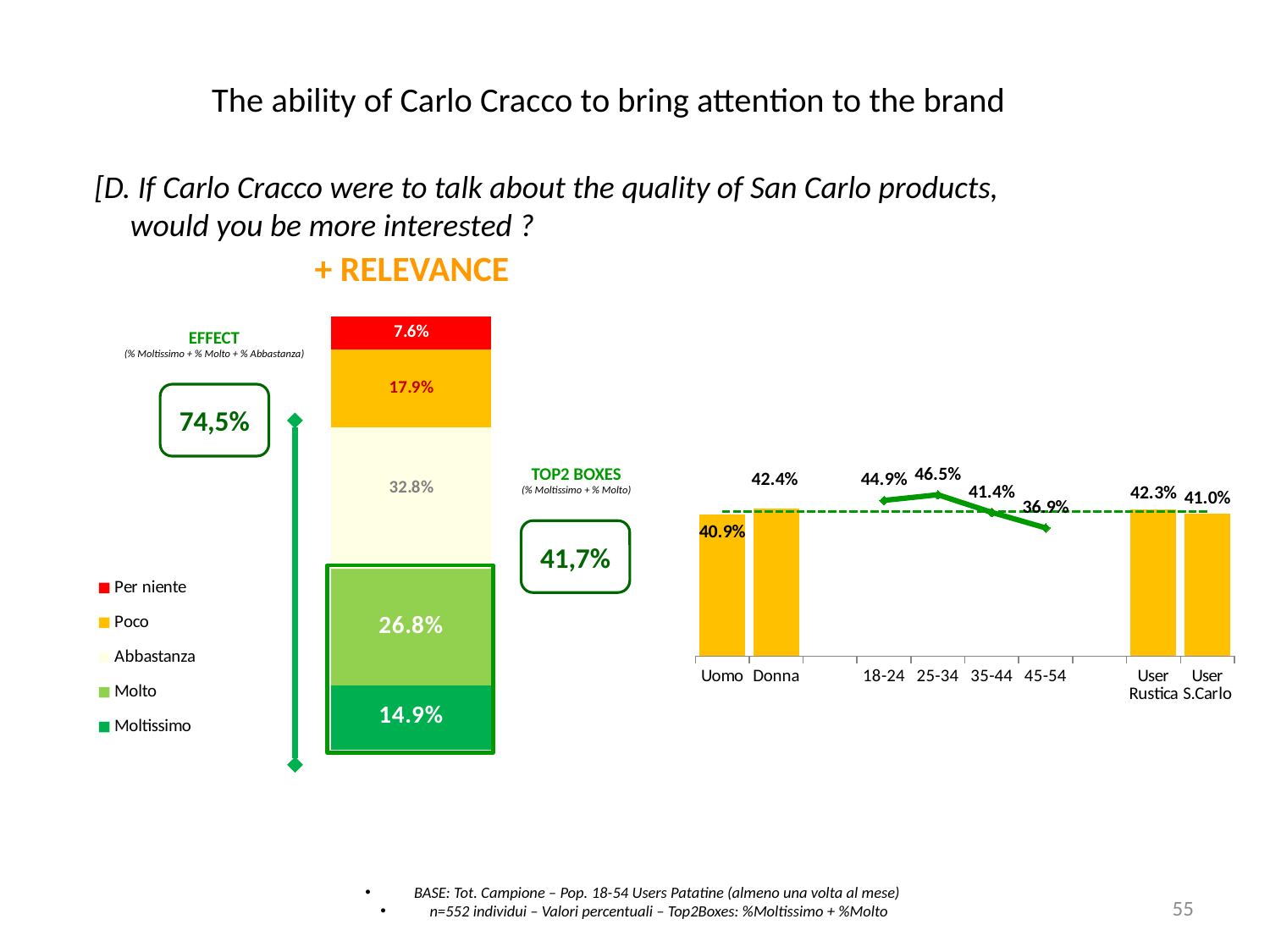
In the stacked bar chart on the left, which segment has the smallest value? Per niente In the stacked bar chart on the left, what is the value of the Abbastanza segment? 32.8% In the chart on the right, what is the difference between the values for 18-24 and 45-54? 8.0% In the chart on the right, which is larger, the value for Uomo or the value for Donna? Donna In the stacked bar chart on the left, what is the value of the Per niente segment? 7.6% In the chart on the right, what is the value for the 45-54 age group? 36.9% In the stacked bar chart on the left, which segment has the largest value? Abbastanza In the chart on the right, what is the value for Donna? 42.4% In the stacked bar chart on the left, what is the difference between the Molto and Moltissimo segments? 11.9% In the chart on the right, which age group has the highest value? 25-34 In the chart on the right, do the values rise or fall from the 25-34 group to the 45-54 group? fall How many entries does the legend of the stacked bar chart on the left list? 5